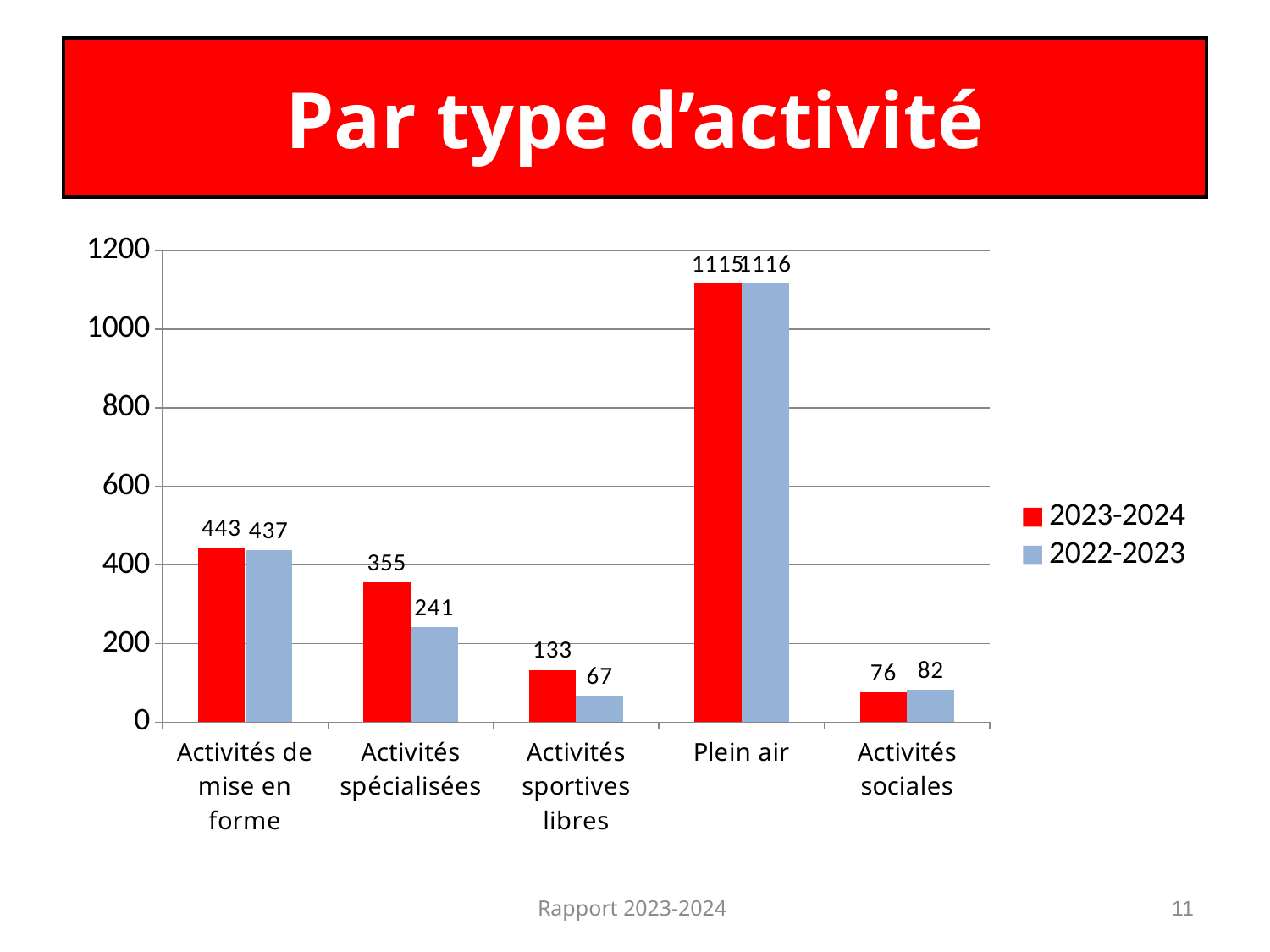
What is the value for Activités sociales in the 2023-2024 series? 76 What kind of chart is shown on the slide? bar chart Which is larger for Activités sociales: the 2023-2024 value or the 2022-2023 value? 2022-2023 What is the value for Activités sportives libres in the 2022-2023 series? 67 Which category has the highest value in the 2023-2024 series? Plein air Is the 2023-2024 value for Plein air greater or less than 1000? greater What is the value for Activités spécialisées in the 2023-2024 series? 355 How many categories are shown on the x axis? 5 Which category has the lowest value in the 2022-2023 series? Activités sportives libres How many series does the legend list? 2 What colour represents the 2023-2024 series? red What is the difference between the 2023-2024 and 2022-2023 values for Activités spécialisées? 114